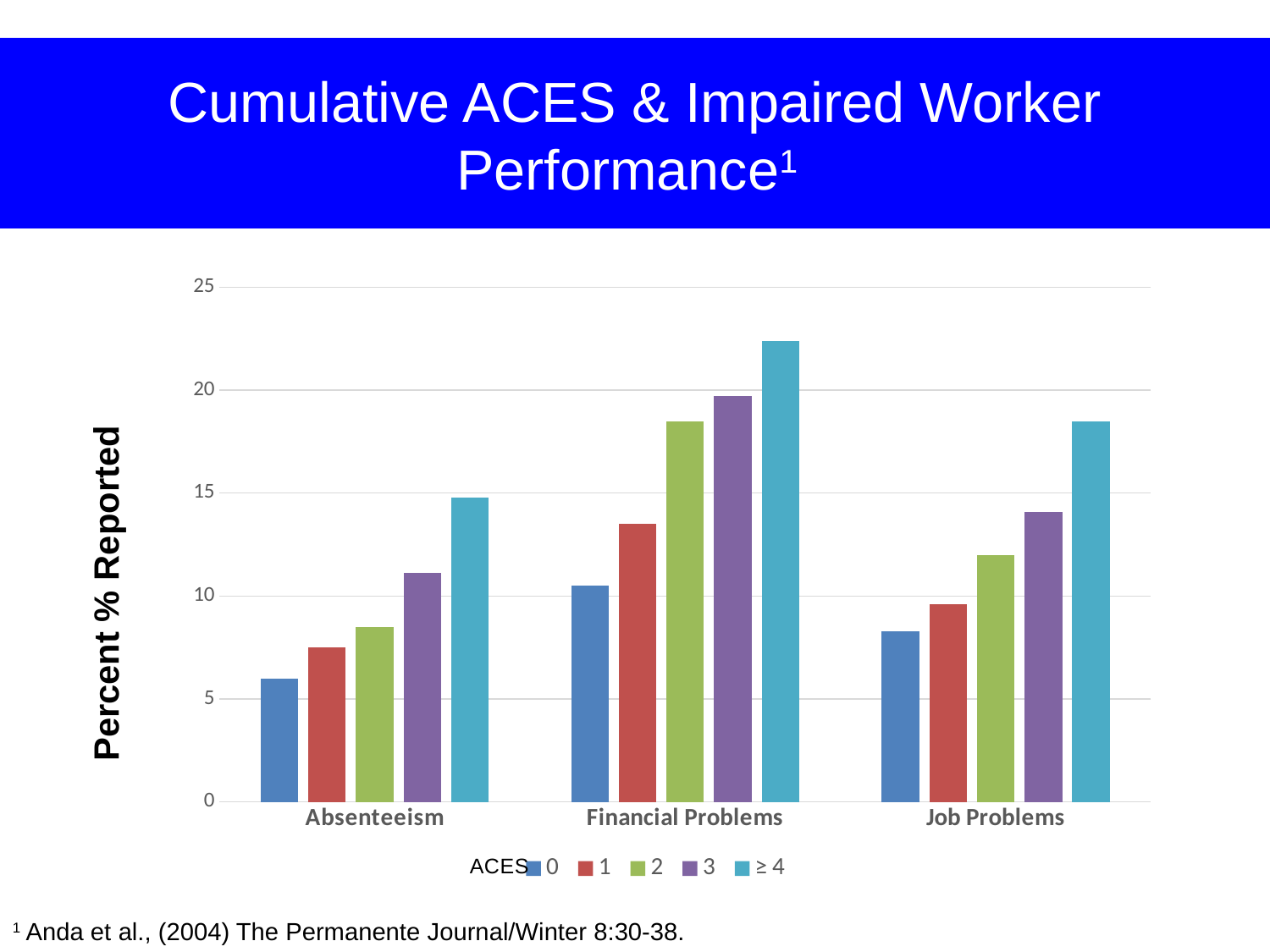
How many categories are shown on the x axis of the chart? 3 Is the value for 3 ACES in Job Problems greater or less than 15? less Which category has the lowest bar for the 0 ACES series? Absenteeism Within each category, do the bars rise or fall as the number of ACES increases from 0 to ≥ 4? rise How many series does the chart's legend list? 5 Within the Financial Problems category, which ACES series has the highest bar? ≥ 4 Is the value for ≥ 4 ACES in Financial Problems greater or less than 20? greater What kind of chart is shown on the slide? bar chart Which is larger: the ≥ 4 ACES bar for Absenteeism or the ≥ 4 ACES bar for Job Problems? Job Problems Within the Job Problems category, which ACES series has the lowest bar? 0 Is the value for 0 ACES in Absenteeism greater or less than 10? less Which category has the highest bar for the ≥ 4 ACES series? Financial Problems